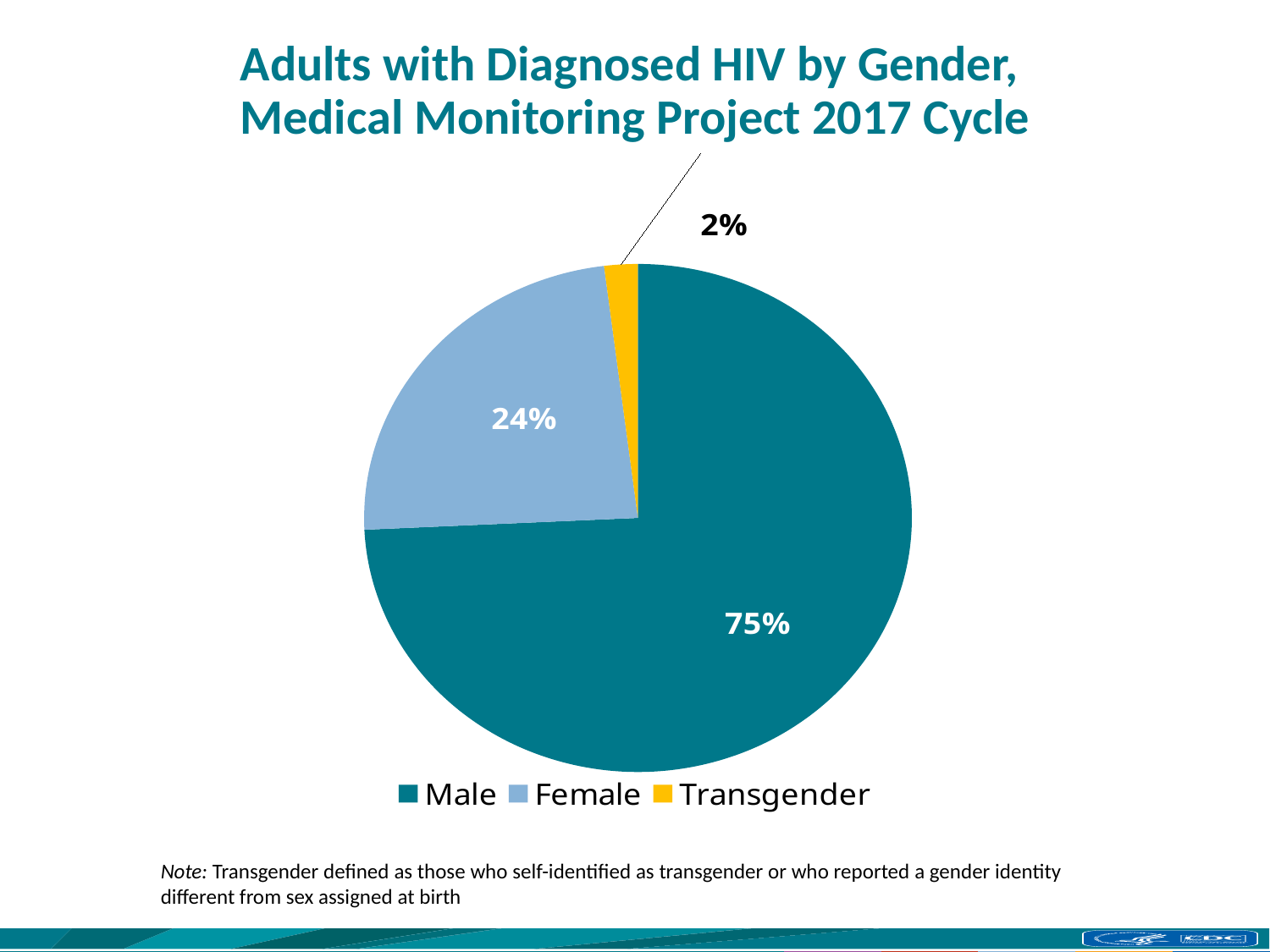
What is the difference in percentage points between the Male and Female shares? 51 What share of adults with diagnosed HIV are Female? 24% Which colour represents the Transgender slice in the legend? yellow What is the title of the chart? Adults with Diagnosed HIV by Gender, Medical Monitoring Project 2017 Cycle What kind of chart is shown on the slide? pie chart Which gender category has the largest share of the pie? Male What share of adults with diagnosed HIV are Male? 75% Which is larger, the Female share or the Transgender share? Female What share of adults with diagnosed HIV are Transgender? 2% Which gender category has the smallest share of the pie? Transgender What is the difference in percentage points between the Female and Transgender shares? 22 How many categories does the pie chart show? 3